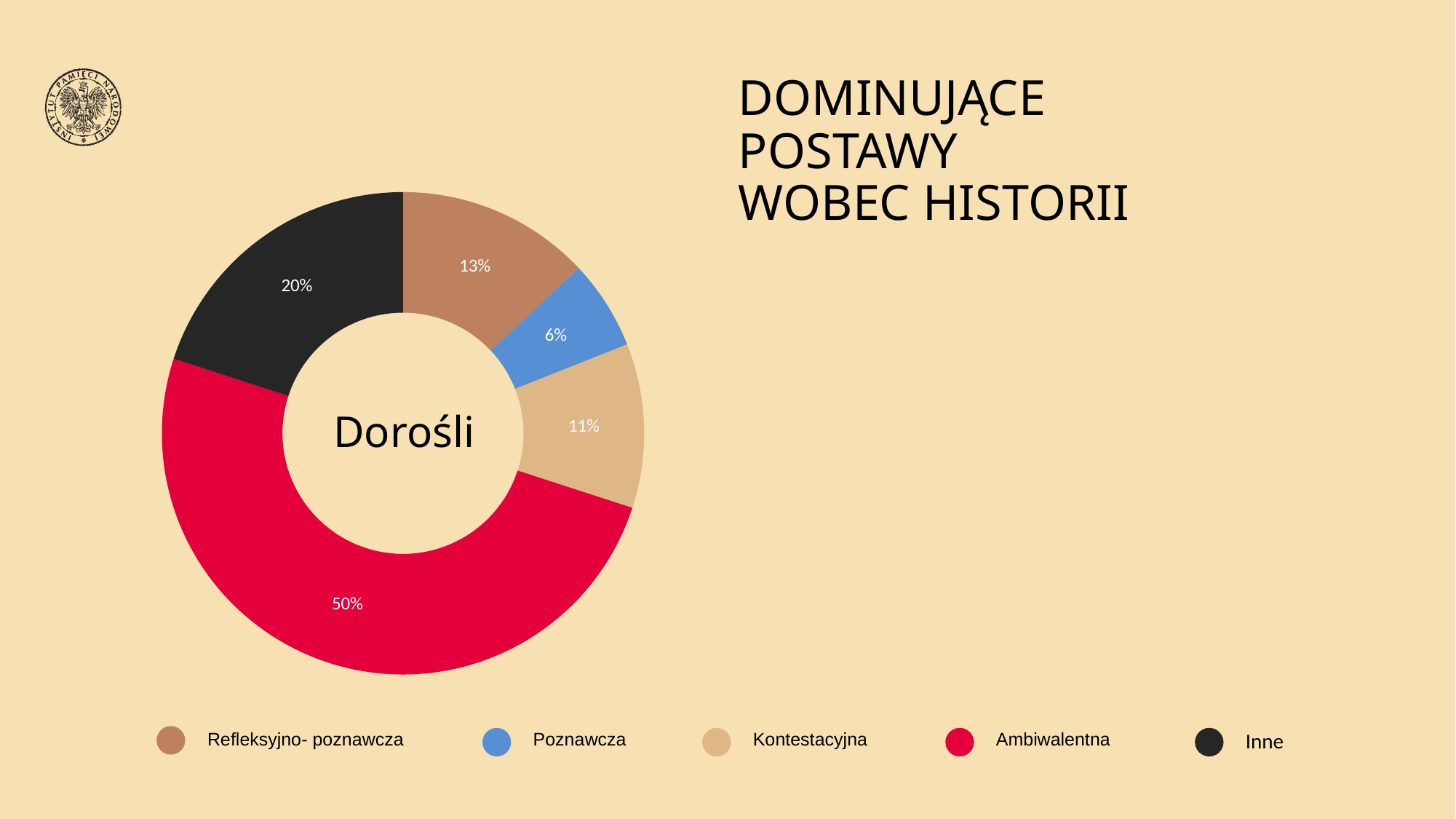
What is the difference in percentage points between Ambiwalentna and Inne? 30 What percentage does the Inne slice show? 20% Which is larger, Refleksyjno- poznawcza or Kontestacyjna? Refleksyjno- poznawcza What label appears in the centre of the donut chart? Dorośli What is the value shown for Kontestacyjna? 11% How many categories does the legend list? 5 What percentage of the donut chart is labelled Ambiwalentna? 50% What is the value shown for Poznawcza? 6% Which category has the smallest share of the chart? Poznawcza Which category has the largest share of the chart? Ambiwalentna What is the value shown for Refleksyjno- poznawcza? 13% What kind of chart is shown on the slide? Donut (pie) chart